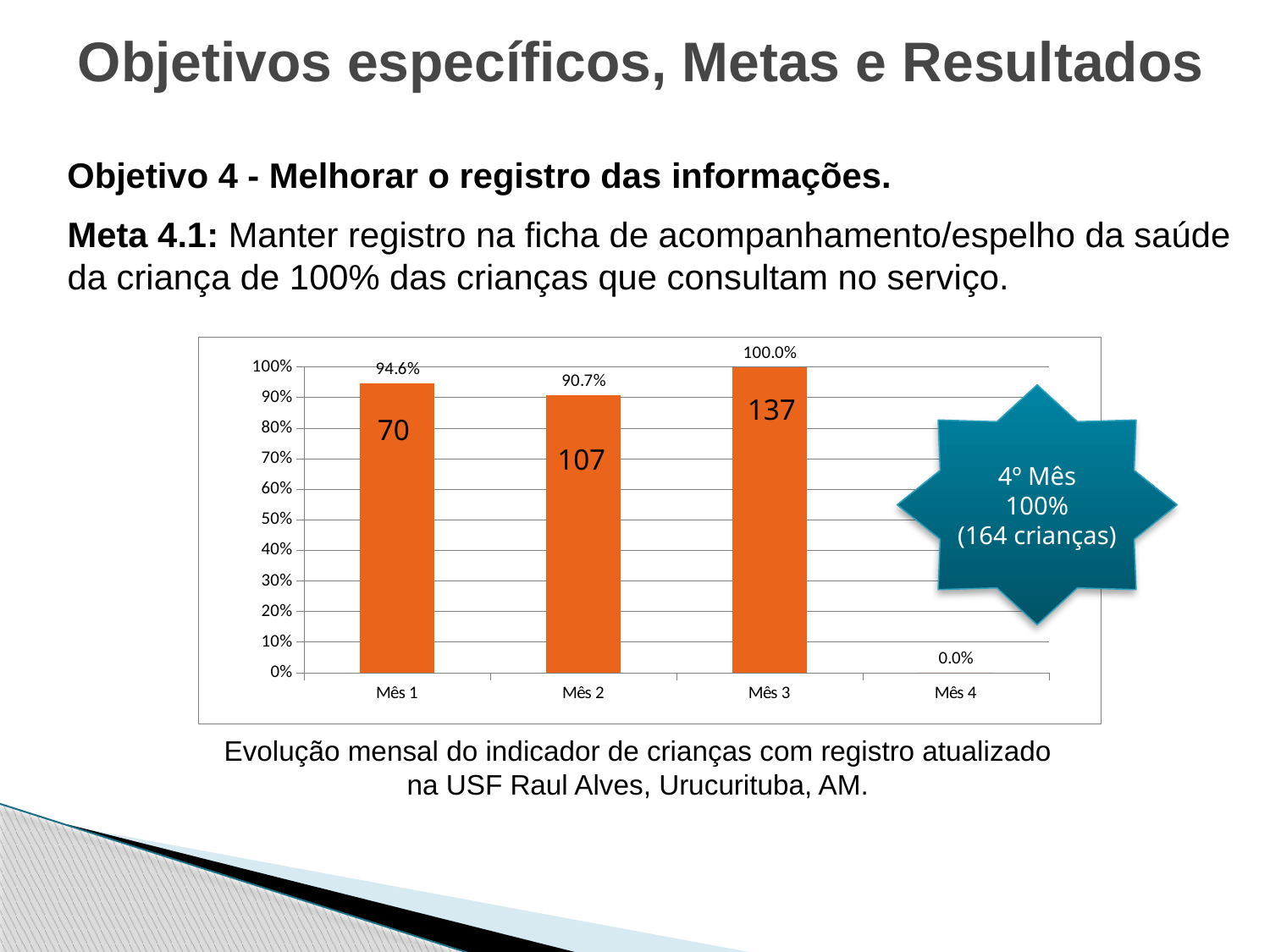
What percentage is shown for Mês 3? 100.0% How many months are shown on the x axis of the chart? 4 Which is larger, the percentage for Mês 1 or for Mês 2? Mês 1 Which month has the highest percentage on the chart? Mês 3 What percentage is shown for Mês 1? 94.6% What percentage is shown for Mês 2? 90.7% Which month has the lowest percentage on the chart? Mês 4 What is the difference in percentage points between Mês 1 and Mês 2? 3.9 What number is printed inside the bar for Mês 2? 107 What percentage label is shown for Mês 4 on the chart? 0.0% What number is printed inside the bar for Mês 3? 137 What kind of chart is shown on the slide? Bar chart